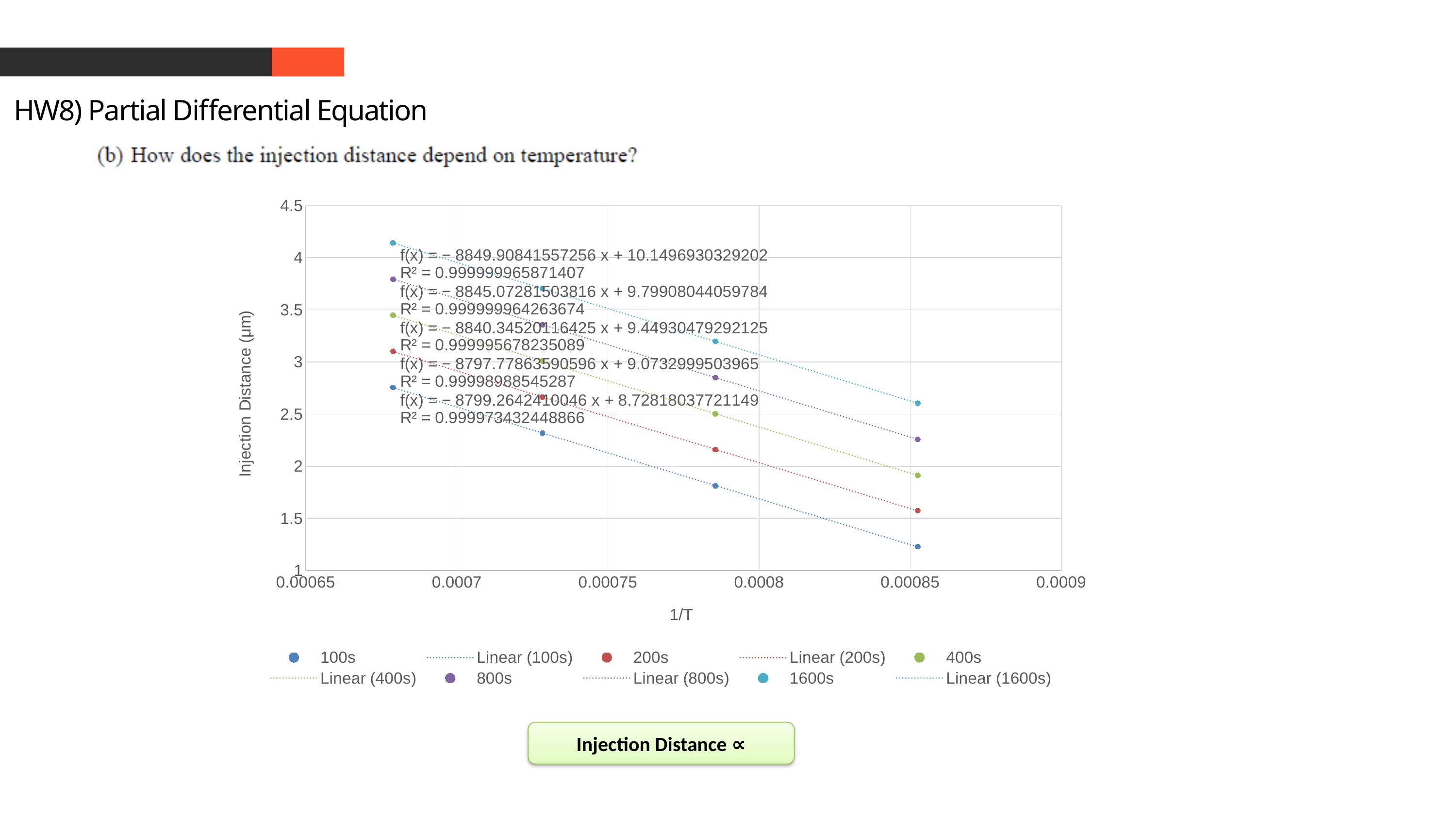
At 1/T = 0.00085, is the injection distance for the 100s series greater or less than 1.5? less At 1/T = 0.00068, is the injection distance for the 1600s series greater or less than 4? greater What kind of chart is shown on the slide? scatter chart Do the injection distance values rise or fall as 1/T increases along the x axis? fall At 1/T = 0.00085, which series has the larger injection distance, 1600s or 100s? 1600s How many data points are plotted for the 100s series? 4 At 1/T = 0.00085, is the injection distance for the 800s series greater or less than 2.5? less Which series has the highest injection distance values? 1600s What is the title of the y axis? Injection Distance (μm) How many entries does the chart legend list? 10 Which series has the lowest injection distance values? 100s What is the title of the x axis? 1/T